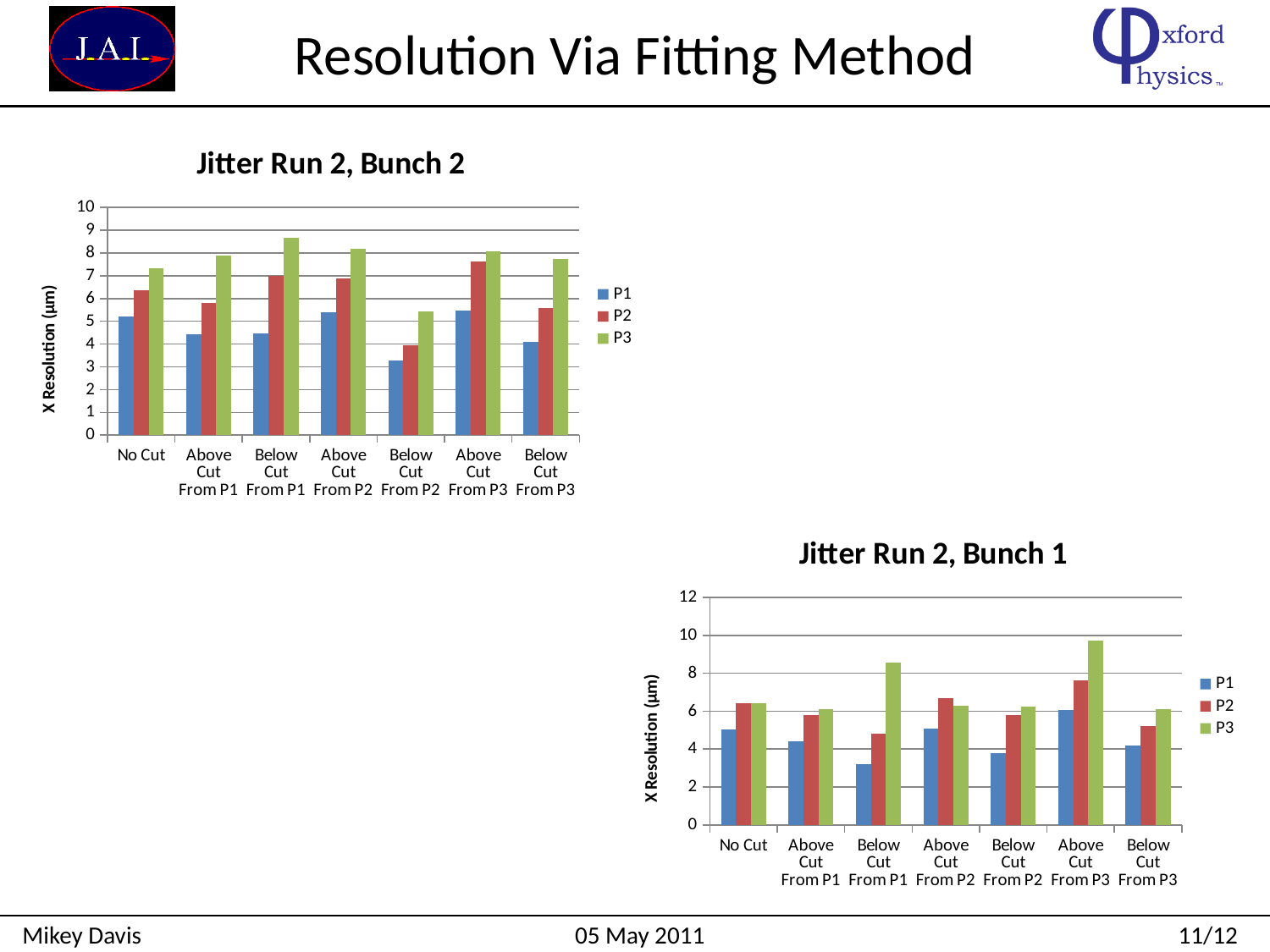
In the "Jitter Run 2, Bunch 2" chart, how many categories are shown on the x axis? 7 In the "Jitter Run 2, Bunch 2" chart, which category has the lowest P1 value? Below Cut From P2 In the "Jitter Run 2, Bunch 1" chart, which category has the highest P3 value? Above Cut From P3 In the "Jitter Run 2, Bunch 1" chart, is the P3 value for Above Cut From P3 greater or less than 8? greater In the "Jitter Run 2, Bunch 2" chart, is the P3 value for Below Cut From P1 greater or less than 8? greater In the "Jitter Run 2, Bunch 2" chart, how many series does the legend list? 3 In the "Jitter Run 2, Bunch 1" chart, which category has the lowest P1 value? Below Cut From P1 What is the y-axis label of the "Jitter Run 2, Bunch 1" chart? X Resolution (μm) What kind of chart is "Jitter Run 2, Bunch 2"? bar chart In the "Jitter Run 2, Bunch 2" chart, is the P1 value for Below Cut From P2 greater or less than 4? less In the "Jitter Run 2, Bunch 2" chart, which category has the highest P3 value? Below Cut From P1 In the "Jitter Run 2, Bunch 2" chart, for Above Cut From P1, which is larger: P2 or P3? P3